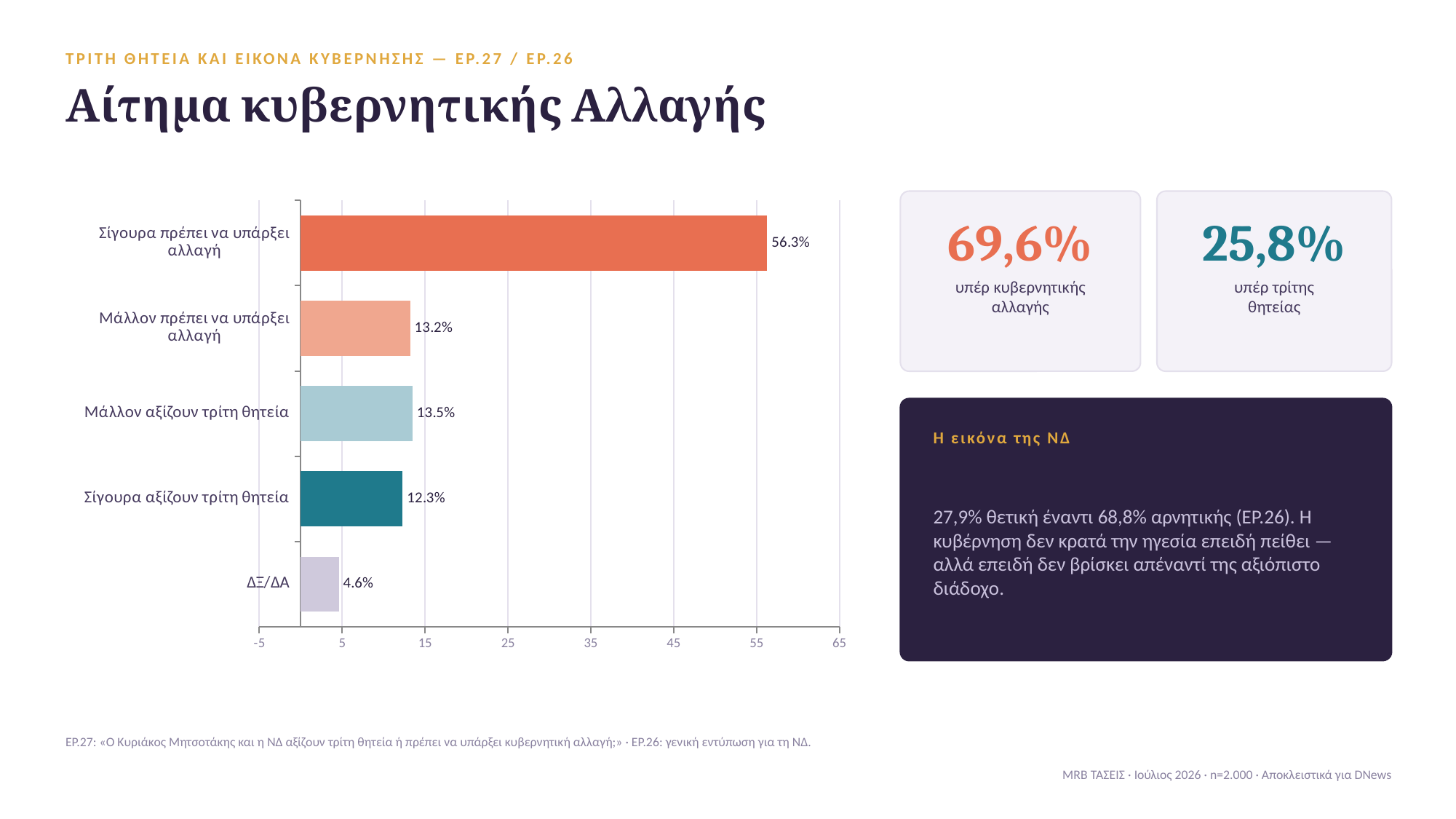
Which category has the highest value? Σίγουρα πρέπει να υπάρξει αλλαγή What type of chart is shown on the slide? bar chart What is the value for "Μάλλον πρέπει να υπάρξει αλλαγή"? 13.2% What is the value for "Μάλλον αξίζουν τρίτη θητεία"? 13.5% What is the value for "Σίγουρα πρέπει να υπάρξει αλλαγή"? 56.3% Which is larger: the value for "Σίγουρα αξίζουν τρίτη θητεία" or the value for "ΔΞ/ΔΑ"? Σίγουρα αξίζουν τρίτη θητεία How many categories are shown in the chart? 5 What is the difference between the values for "Σίγουρα πρέπει να υπάρξει αλλαγή" and "Σίγουρα αξίζουν τρίτη θητεία"? 44.0% What is the difference between the values for "Μάλλον αξίζουν τρίτη θητεία" and "Μάλλον πρέπει να υπάρξει αλλαγή"? 0.3% Which category has the lowest value? ΔΞ/ΔΑ What is the value for "Σίγουρα αξίζουν τρίτη θητεία"? 12.3% What is the value for "ΔΞ/ΔΑ"? 4.6%